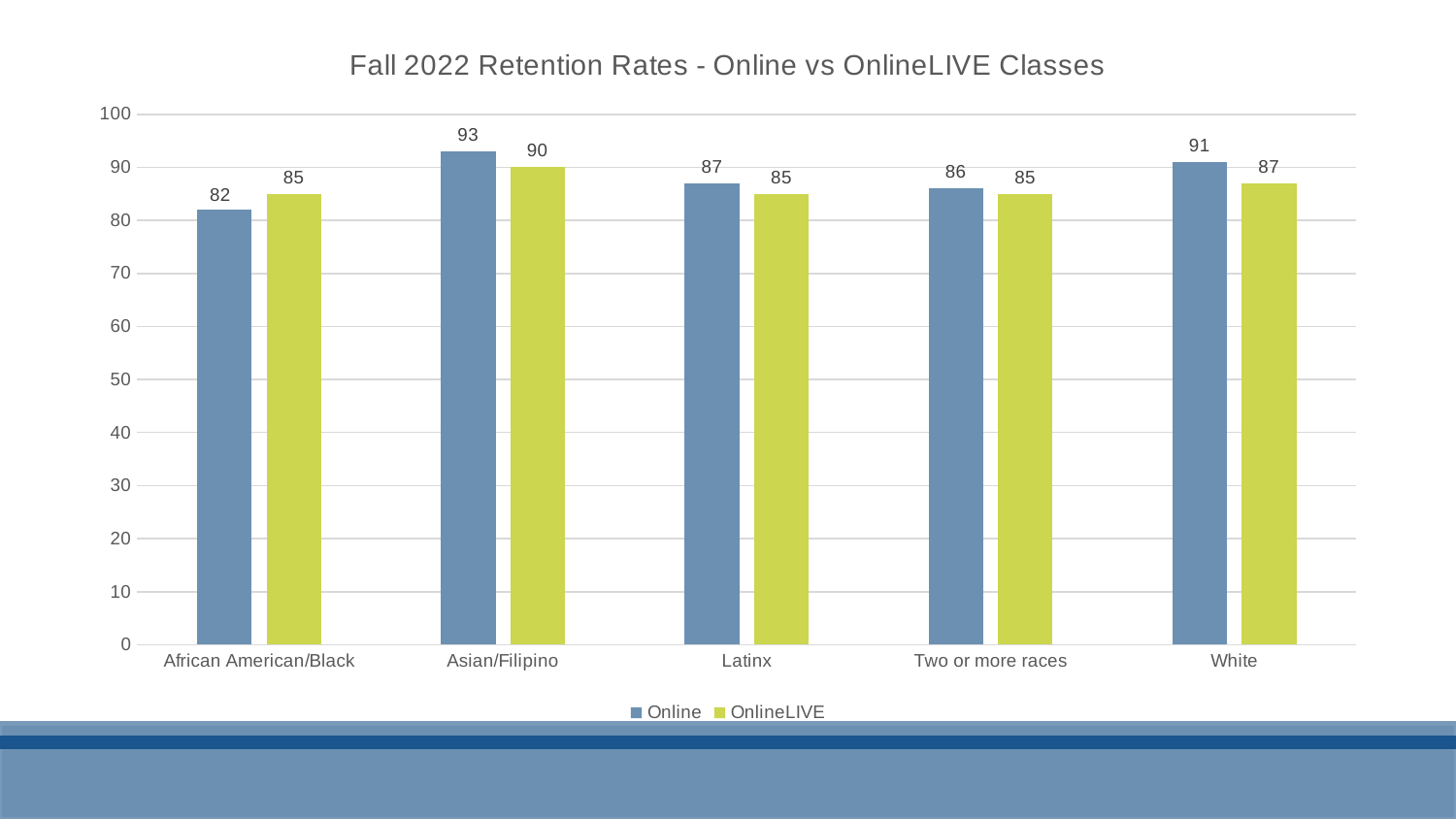
For African American/Black students, which is higher: the Online or the OnlineLIVE retention rate? OnlineLIVE Which category has the lowest Online retention rate? African American/Black What is the OnlineLIVE retention rate for Asian/Filipino students? 90 What is the difference between the Online and OnlineLIVE retention rates for Latinx students? 2 What is the Online retention rate for African American/Black students? 82 How many categories are shown on the x axis? 5 Which category has the highest Online retention rate? Asian/Filipino How many series does the legend list? 2 What kind of chart is shown on the slide? Bar chart What is the title of the chart? Fall 2022 Retention Rates - Online vs OnlineLIVE Classes What is the Online retention rate for White students? 91 What is the OnlineLIVE retention rate for Two or more races? 85